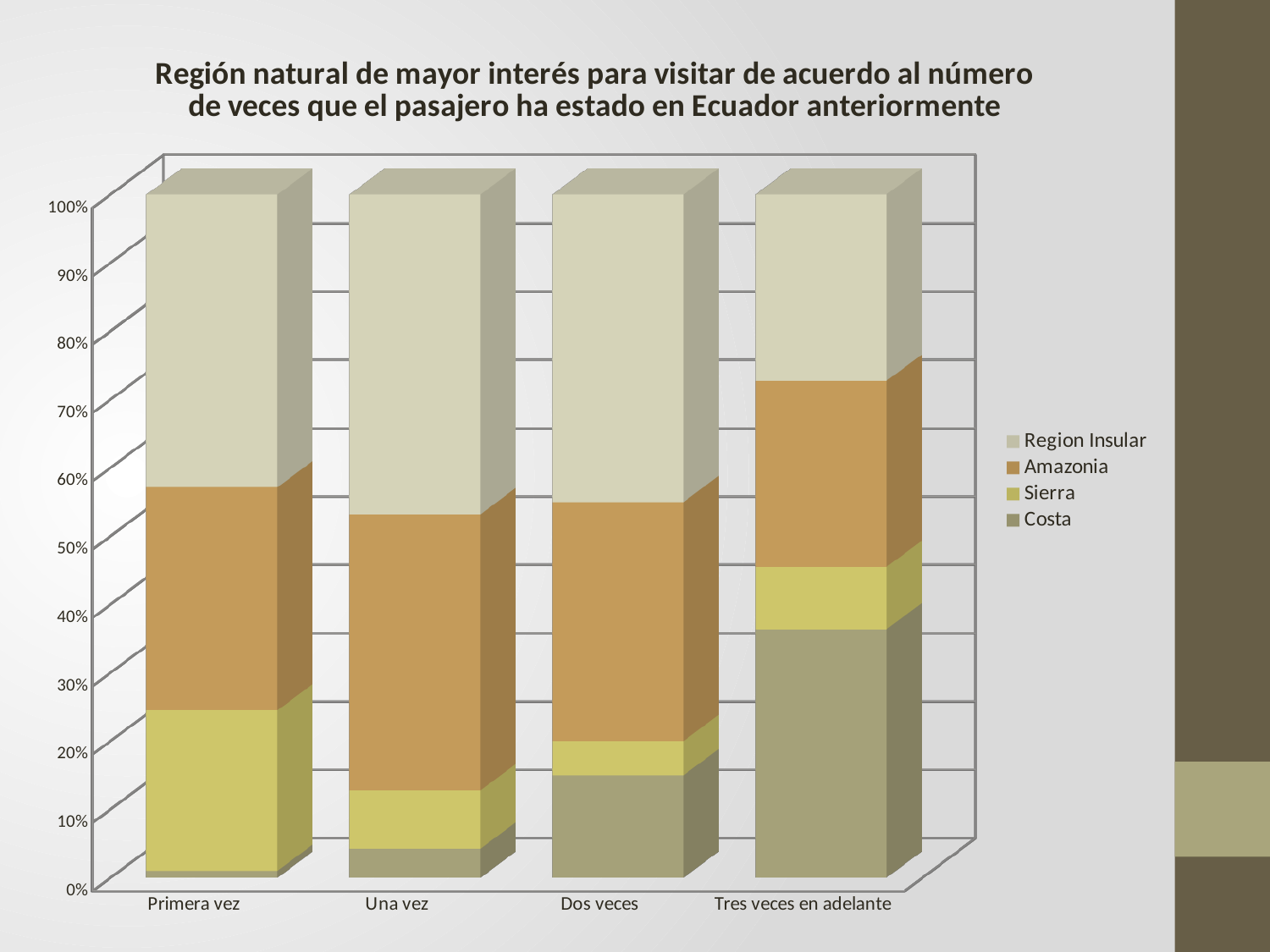
For which category is the Costa segment the largest? Tres veces en adelante Which series is listed last in the legend? Costa Does the Costa share rise or fall moving from Primera vez to Tres veces en adelante? rise What kind of chart is shown on the slide? Stacked bar chart Is the Costa share for Tres veces en adelante greater or less than 30%? greater For which category is the Costa segment the smallest? Primera vez How many series does the legend list? 4 Is the Costa share for Primera vez greater or less than 10%? less What is the label of the rightmost category on the x axis? Tres veces en adelante For which category is the Sierra segment the largest? Primera vez For which category is the Region Insular segment the smallest? Tres veces en adelante How many categories are shown on the x axis? 4